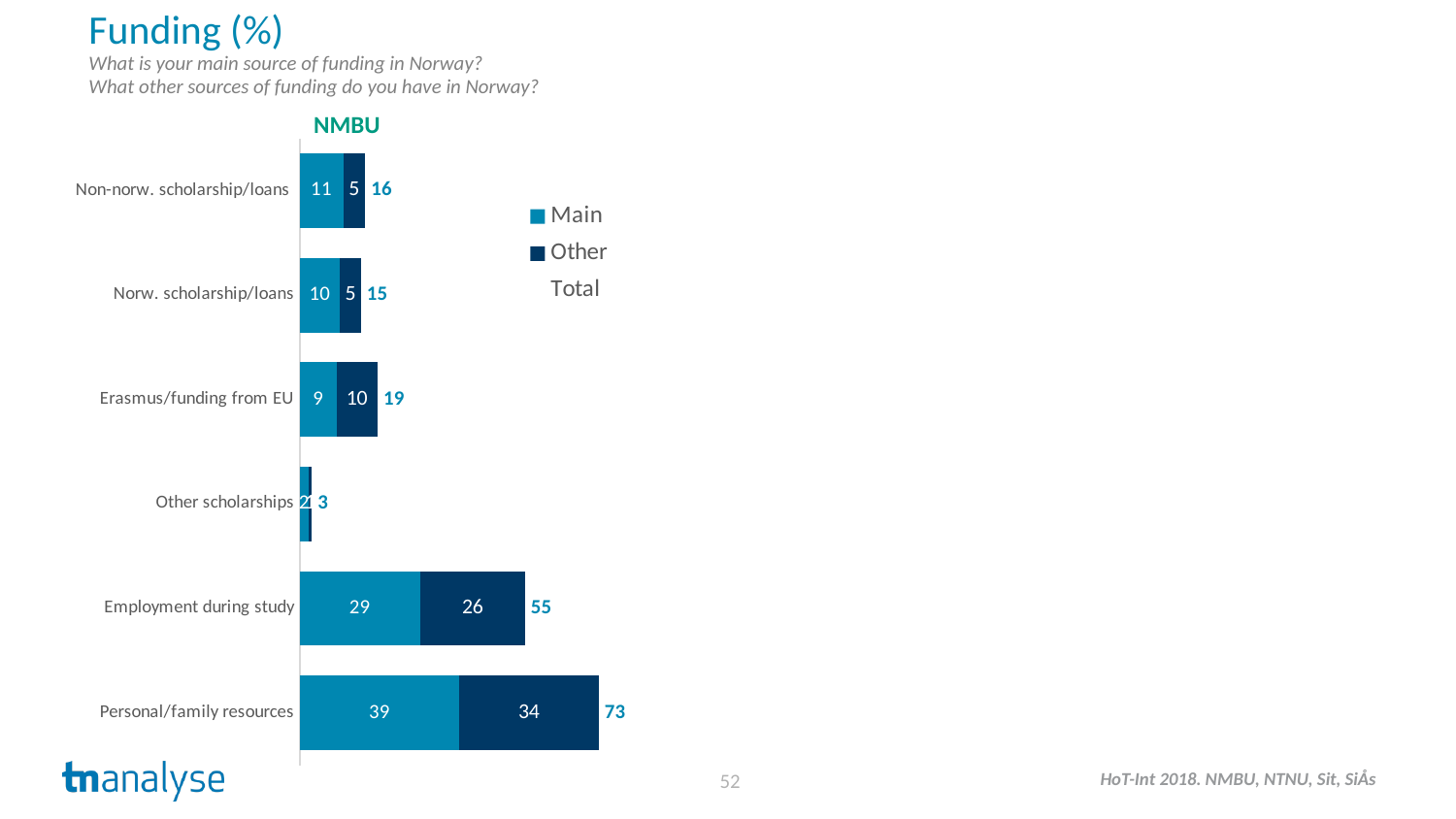
How many entries does the legend list? 3 What is the heading shown above the chart? NMBU Which is larger, the Other value for Erasmus/funding from EU or the Other value for Norw. scholarship/loans? Erasmus/funding from EU What is the difference between the Total values for Personal/family resources and Employment during study? 18 What is the Total value for Erasmus/funding from EU? 19 Which category has the lowest Total value? Other scholarships What is the Main value for Personal/family resources? 39 What is the Other value for Employment during study? 26 How many categories are shown in the chart? 6 What is the Main value for Non-norw. scholarship/loans? 11 What kind of chart is shown on the slide? Stacked bar chart Which category has the highest Total value? Personal/family resources